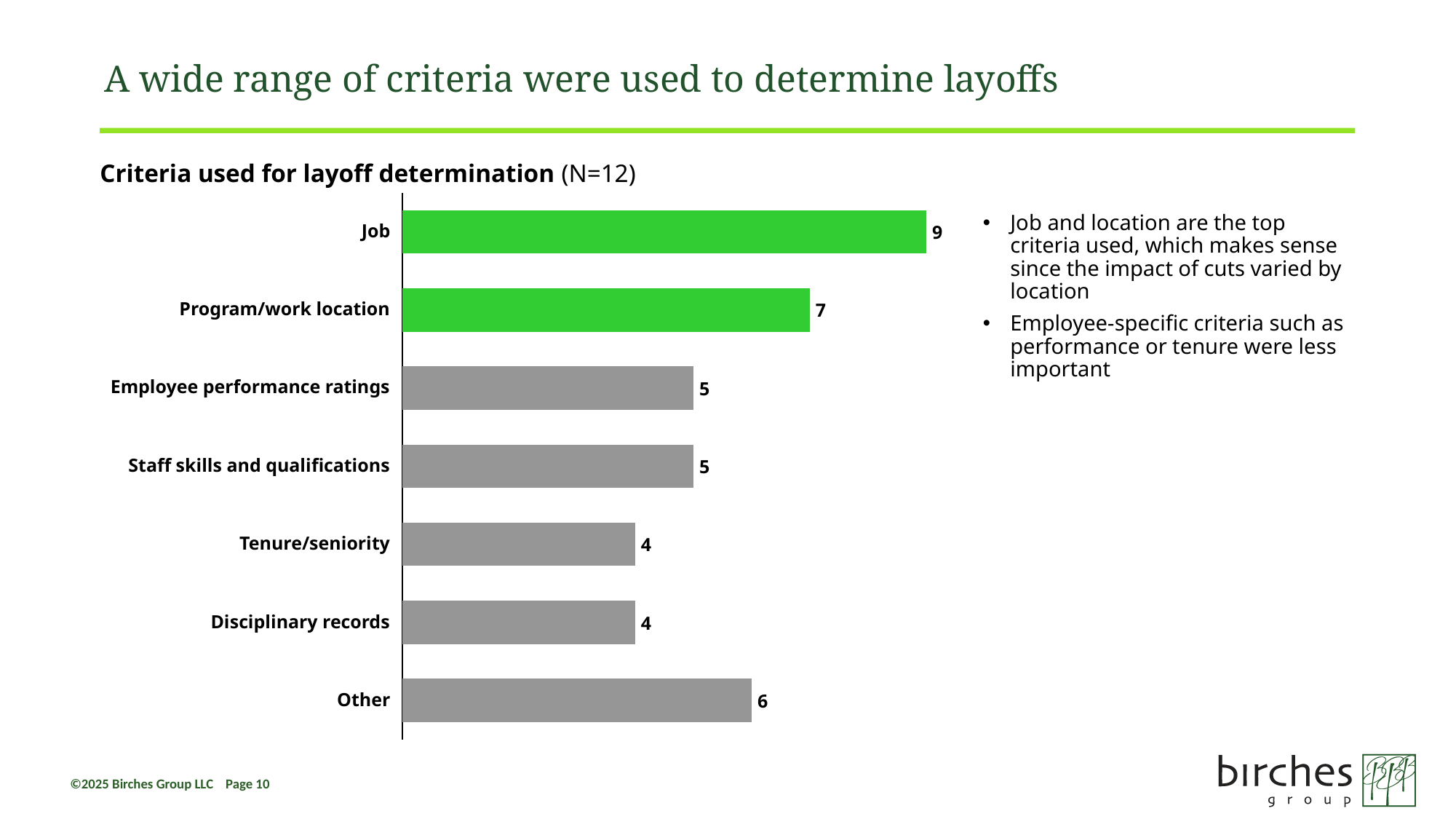
What kind of chart is shown on the slide? Bar chart Which criterion has the highest value in the chart? Job What value is shown for Other? 6 What value is shown for Tenure/seniority? 4 What is the title of the chart? Criteria used for layoff determination (N=12) Which bars in the chart are coloured green? Job and Program/work location What is the difference between the values for Other and Disciplinary records? 2 How many criteria are shown in the chart? 7 Which is larger, the value for Employee performance ratings or the value for Other? Other What value is shown for Program/work location? 7 What is the difference between the values for Job and Program/work location? 2 What value is shown for Job in the chart? 9